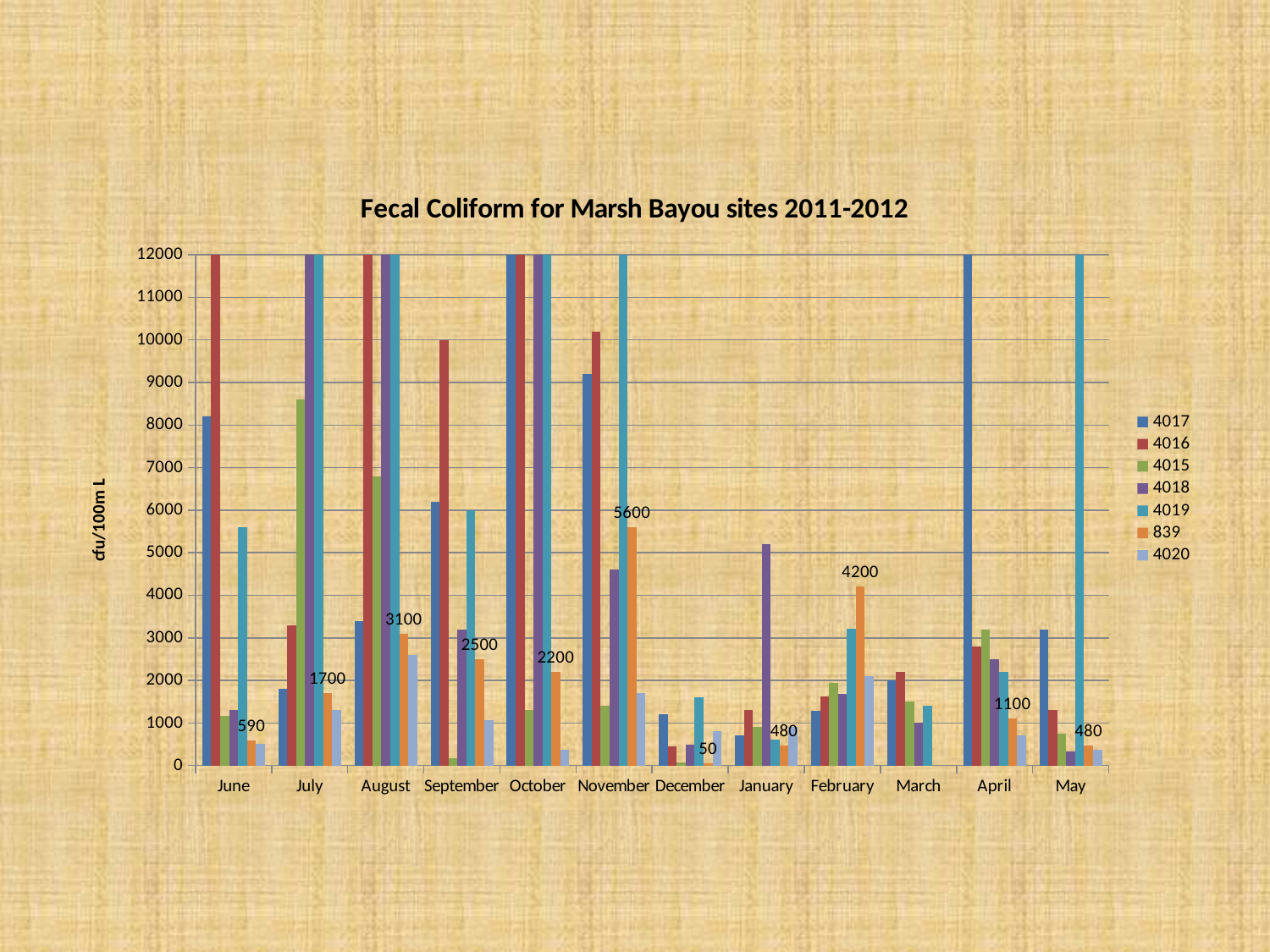
What is the title of the chart? Fecal Coliform for Marsh Bayou sites 2011-2012 How many series does the legend list? 7 What is the value for series 839 in February? 4200 How many months are shown along the x axis? 12 In which month is the labelled value for series 839 highest? November Is the value for series 4016 in September greater or less than 9000? greater What is the value for series 839 in November? 5600 What is the difference between the 839 values for November and February? 1400 What is the value for series 839 in December? 50 Which is larger for series 839: the August value or the September value? August In which month is the labelled value for series 839 lowest? December What kind of chart is shown on the slide? bar chart